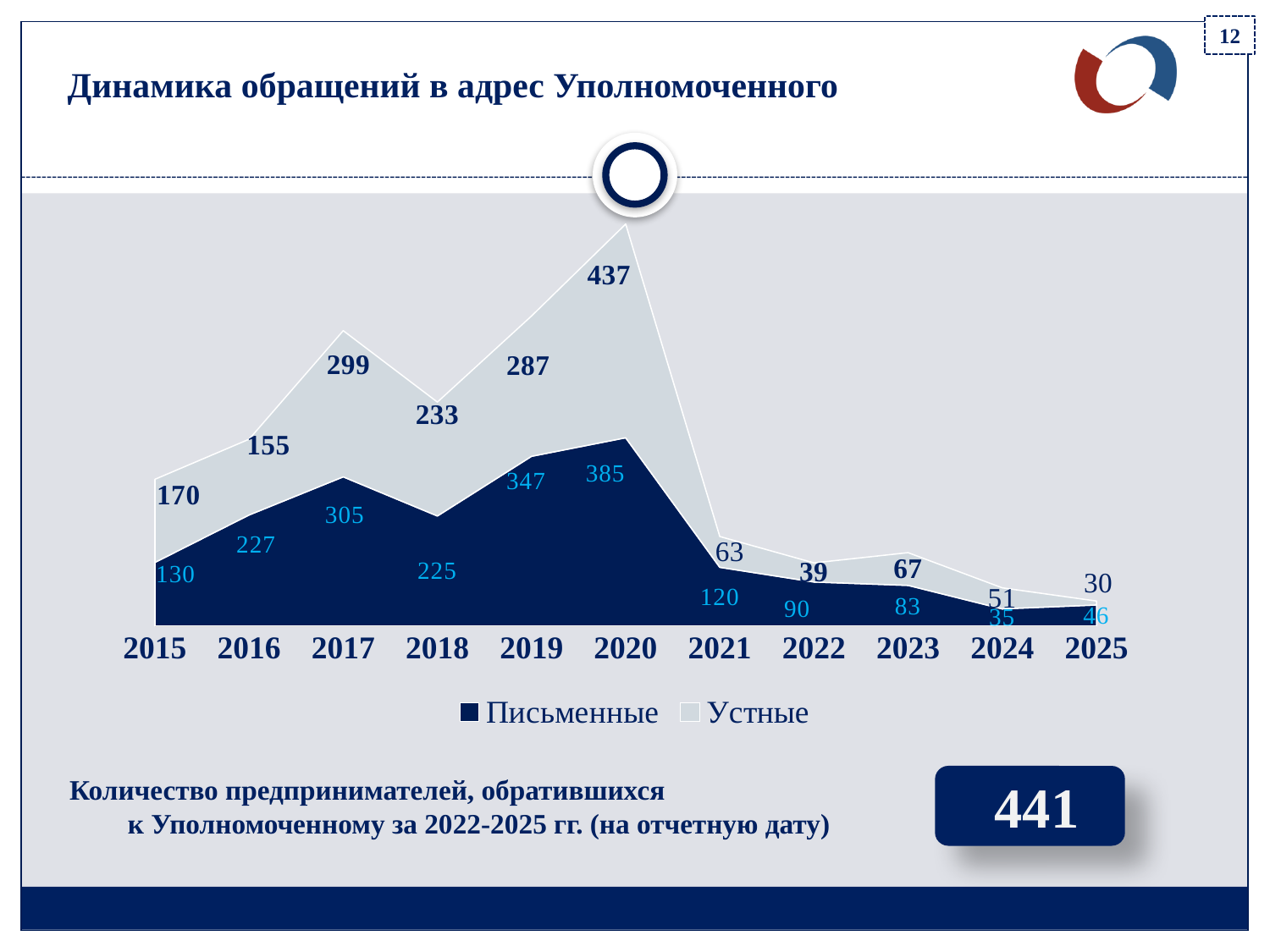
What is the value for Письменные in 2020? 385 How many series does the legend list? 2 In which year is the value for Письменные lowest? 2024 Which is larger in 2018: Письменные or Устные? Устные In which year is the value for Устные highest? 2020 How many years are shown on the x axis? 11 What is the difference between Устные and Письменные in 2020? 52 What is the value for Письменные in 2025? 46 What is the total of Письменные and Устные in 2015? 300 What type of chart is shown on the slide? area chart Do the values for Письменные rise or fall from 2020 to 2024? fall What is the value for Устные in 2017? 299